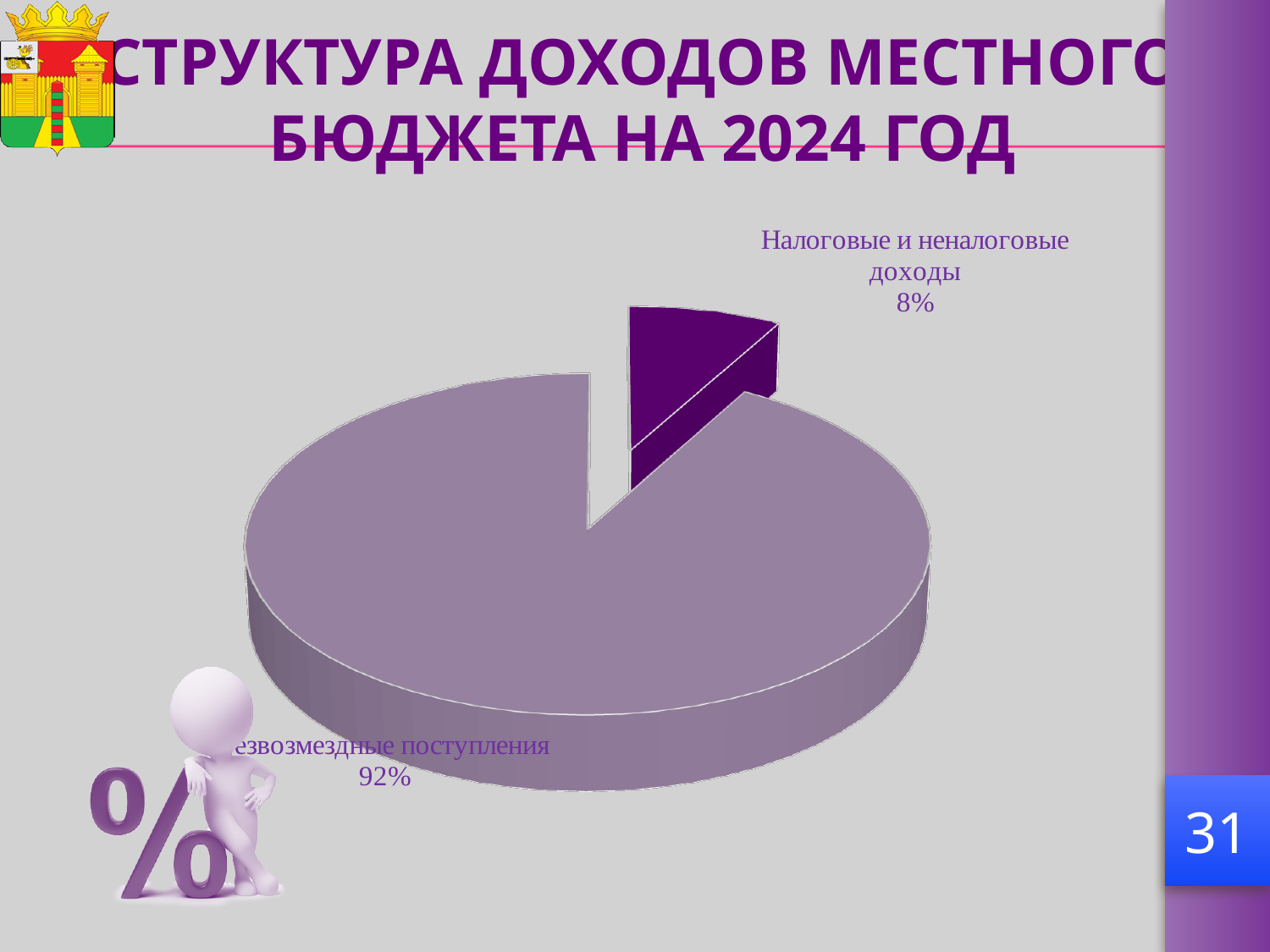
Which is larger: "Налоговые и неналоговые доходы" or "Безвозмездные поступления"? Безвозмездные поступления What share of the pie does "Безвозмездные поступления" have? 92% Is the share for "Налоговые и неналоговые доходы" greater or less than 10%? less What is the title of the slide containing the chart? СТРУКТУРА ДОХОДОВ МЕСТНОГО БЮДЖЕТА НА 2024 ГОД Which slice of the pie is the largest? Безвозмездные поступления Which slice of the pie is the smallest? Налоговые и неналоговые доходы What is the difference in percentage points between "Безвозмездные поступления" and "Налоговые и неналоговые доходы"? 84 percentage points What kind of chart is shown on the slide? Pie chart What colour is the slice for "Налоговые и неналоговые доходы"? Dark purple What share of the pie does "Налоговые и неналоговые доходы" have? 8% How many slices does the pie chart have? 2